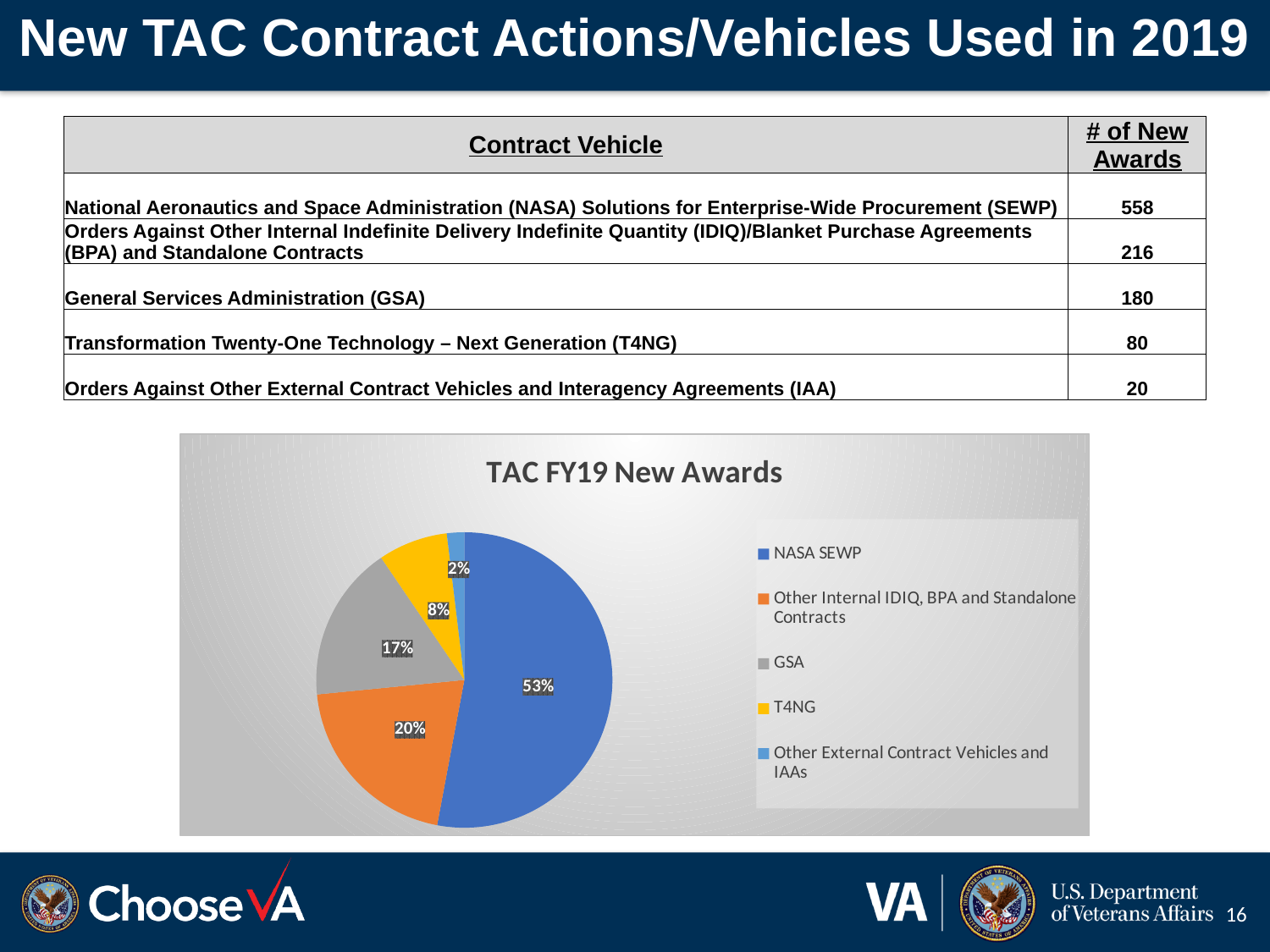
What share of the pie does NASA SEWP represent? 53% What is the difference in percentage points between the NASA SEWP slice and the Other Internal IDIQ, BPA and Standalone Contracts slice? 33% Which category has the largest slice of the pie? NASA SEWP Which is larger, the GSA slice or the T4NG slice? GSA What kind of chart is shown on the slide? pie chart What share of the pie does Other External Contract Vehicles and IAAs represent? 2% Which category has the smallest slice of the pie? Other External Contract Vehicles and IAAs What share of the pie does T4NG represent? 8% What is the title of the chart? TAC FY19 New Awards How many slices does the pie chart have? 5